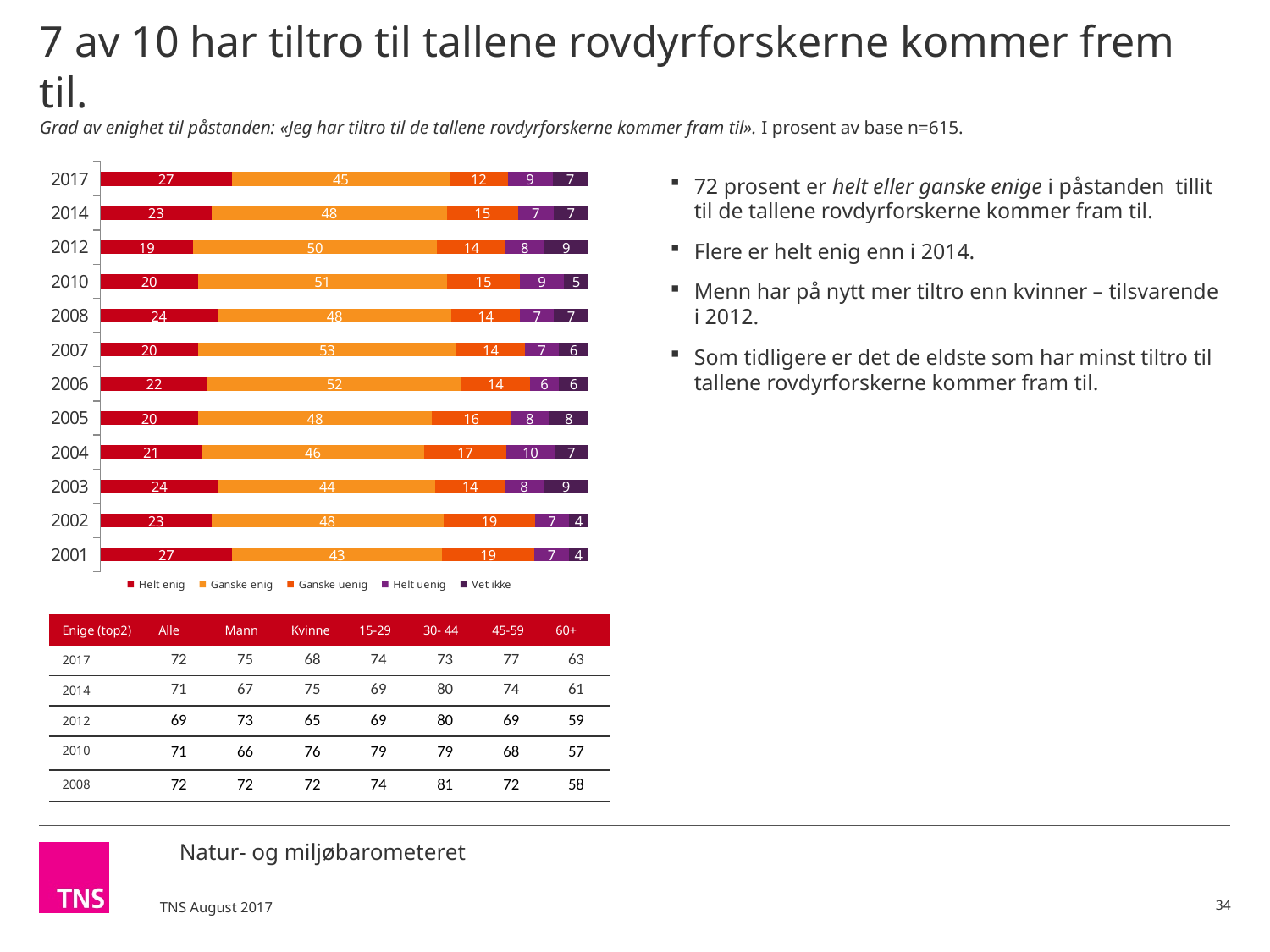
Which year has the lowest value for Helt enig? 2012 What is the value of Ganske enig for 2010? 51 Which is larger, the Ganske uenig value for 2001 or for 2017? 2001 What is the difference between the Helt enig values for 2017 and 2014? 4 What kind of chart is shown on the slide? Stacked bar chart What is the total of the stacked bar for 2017? 100 How many years are shown in the chart? 12 How many series does the legend list? 5 Which year has the highest value for Ganske enig? 2007 What is the value of Helt enig for 2017? 27 What is the first entry in the chart legend? Helt enig What is the value of Vet ikke for 2012? 9